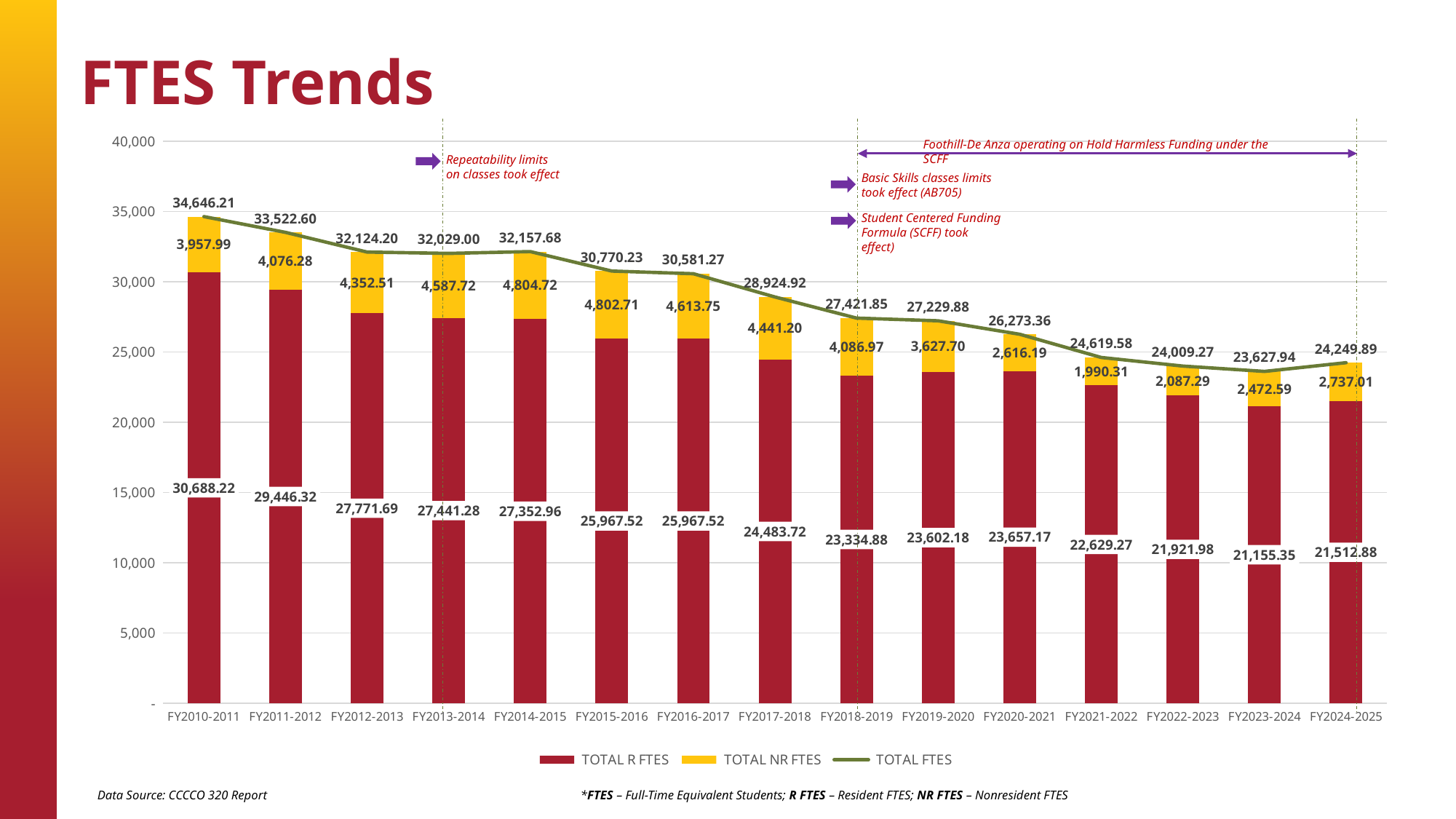
What is the TOTAL R FTES value for FY2010-2011? 30,688.22 What kind of chart is this? Stacked bar chart with a line Which fiscal year has the highest TOTAL FTES? FY2010-2011 What is the difference between the TOTAL R FTES for FY2010-2011 and FY2024-2025? 9,175.34 What is the TOTAL NR FTES value for FY2021-2022? 1,990.31 How many fiscal years are shown on the x axis? 15 Which fiscal year has the lowest TOTAL NR FTES? FY2021-2022 What is the TOTAL FTES value for FY2024-2025? 24,249.89 Does the TOTAL FTES line generally rise or fall from FY2010-2011 to FY2023-2024? Fall Which is larger, the TOTAL NR FTES for FY2012-2013 or for FY2019-2020? FY2012-2013 How many series does the legend list? 3 Which fiscal year has the lowest TOTAL FTES? FY2023-2024